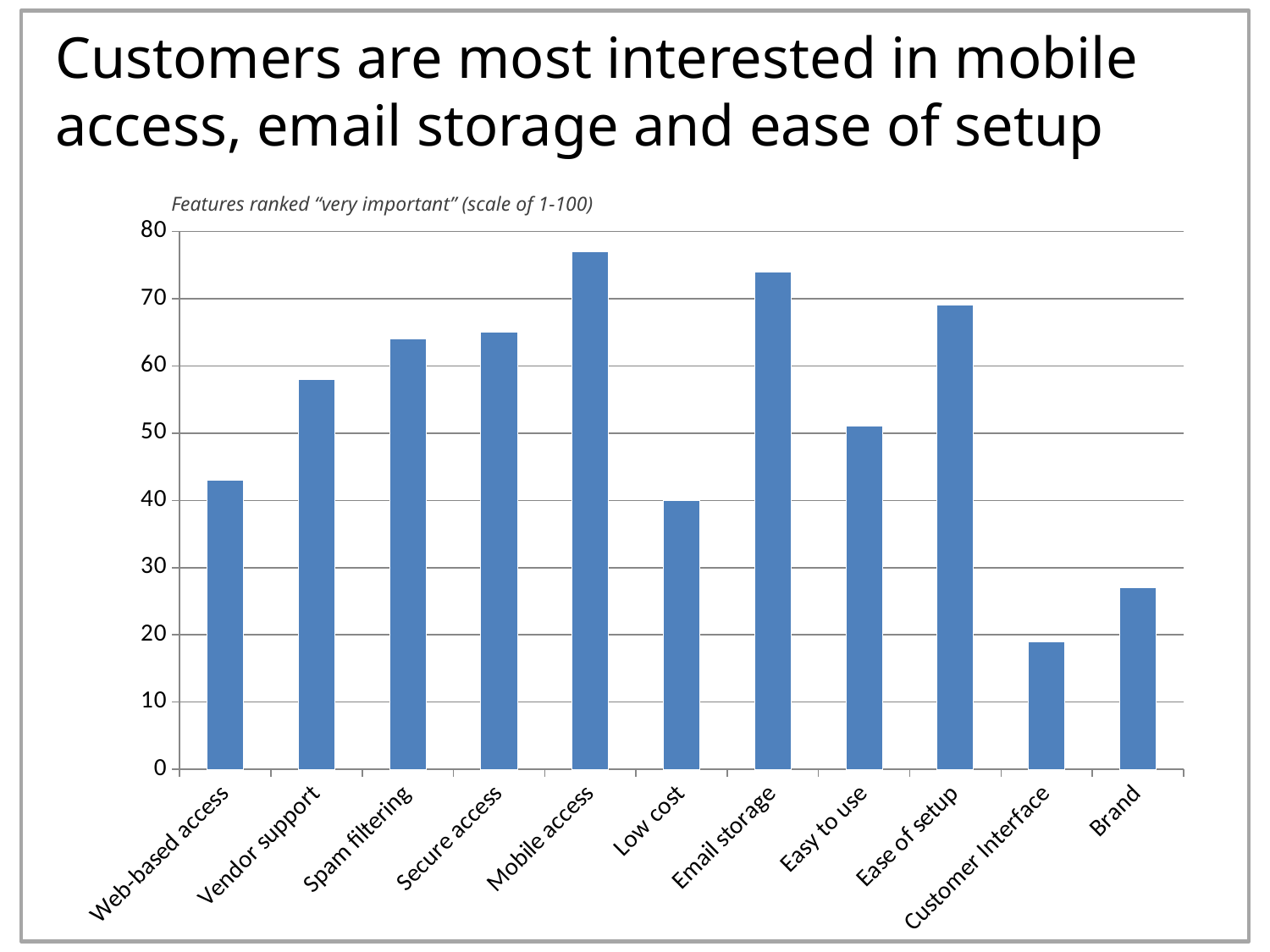
What is the subtitle printed above the chart? Features ranked "very important" (scale of 1-100) Is the value for Mobile access greater or less than 70? greater Which has a higher value, Email storage or Ease of setup? Email storage Is the value for Brand greater or less than 30? less Which feature has the highest bar in the chart? Mobile access Which feature has the lowest bar in the chart? Customer Interface How many features are shown on the x axis of the chart? 11 Which has a higher value, Vendor support or Easy to use? Vendor support Is the value for Vendor support greater or less than 50? greater What kind of chart is shown on the slide? Bar chart